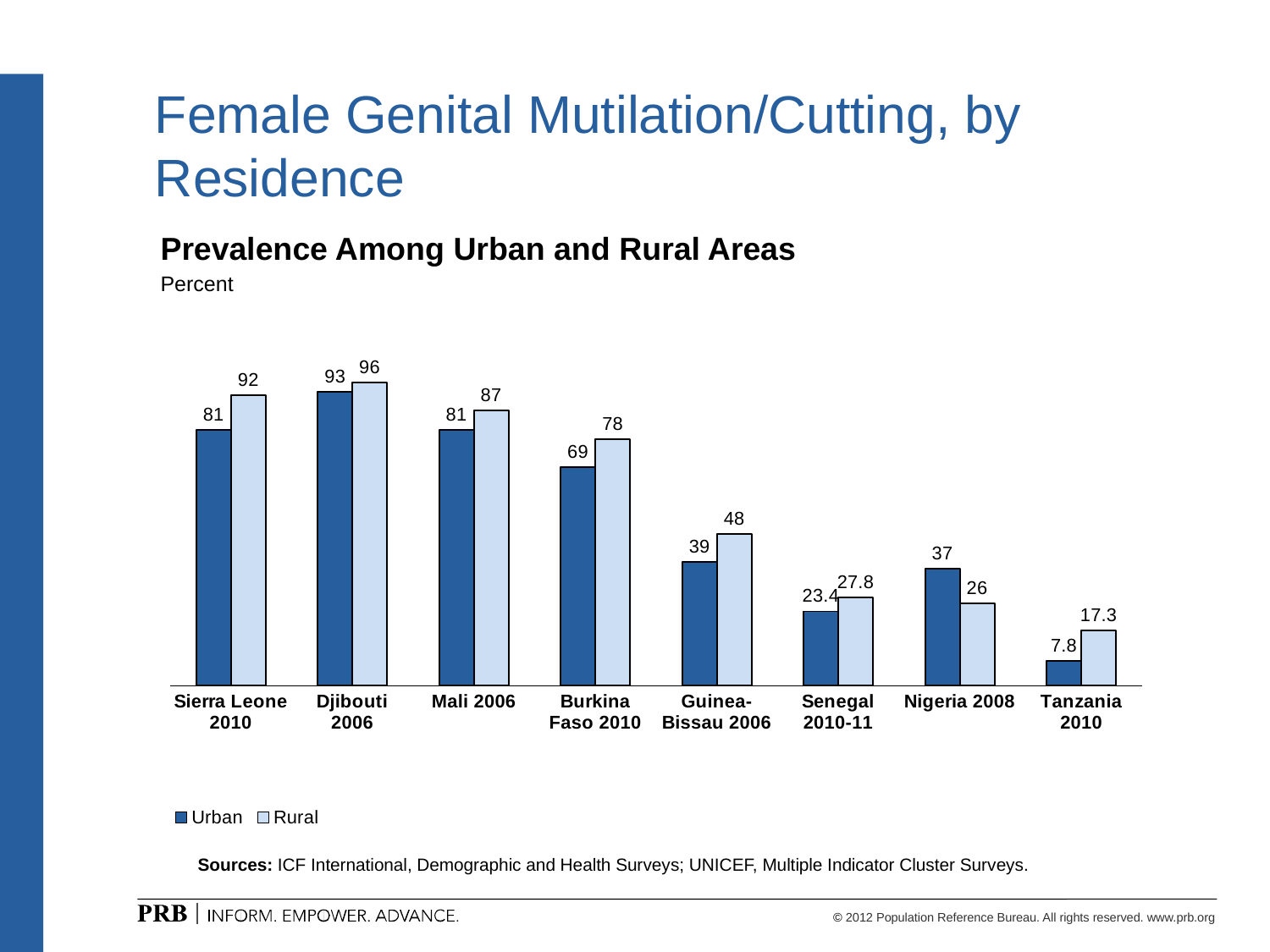
What is the Urban value for Djibouti 2006? 93 What are the two series listed in the legend? Urban and Rural Which country has the highest Rural value? Djibouti 2006 What kind of chart is this? Bar chart What is the Urban value for Senegal 2010-11? 23.4 What is the difference between the Rural and Urban values for Sierra Leone 2010? 11 Which country has the lowest Urban value? Tanzania 2010 What is the difference between the Rural and Urban values for Guinea-Bissau 2006? 9 How many series does the legend list? 2 How many countries are shown on the x axis? 8 What is the Rural value for Tanzania 2010? 17.3 For Nigeria 2008, which is larger, the Urban or the Rural value? Urban